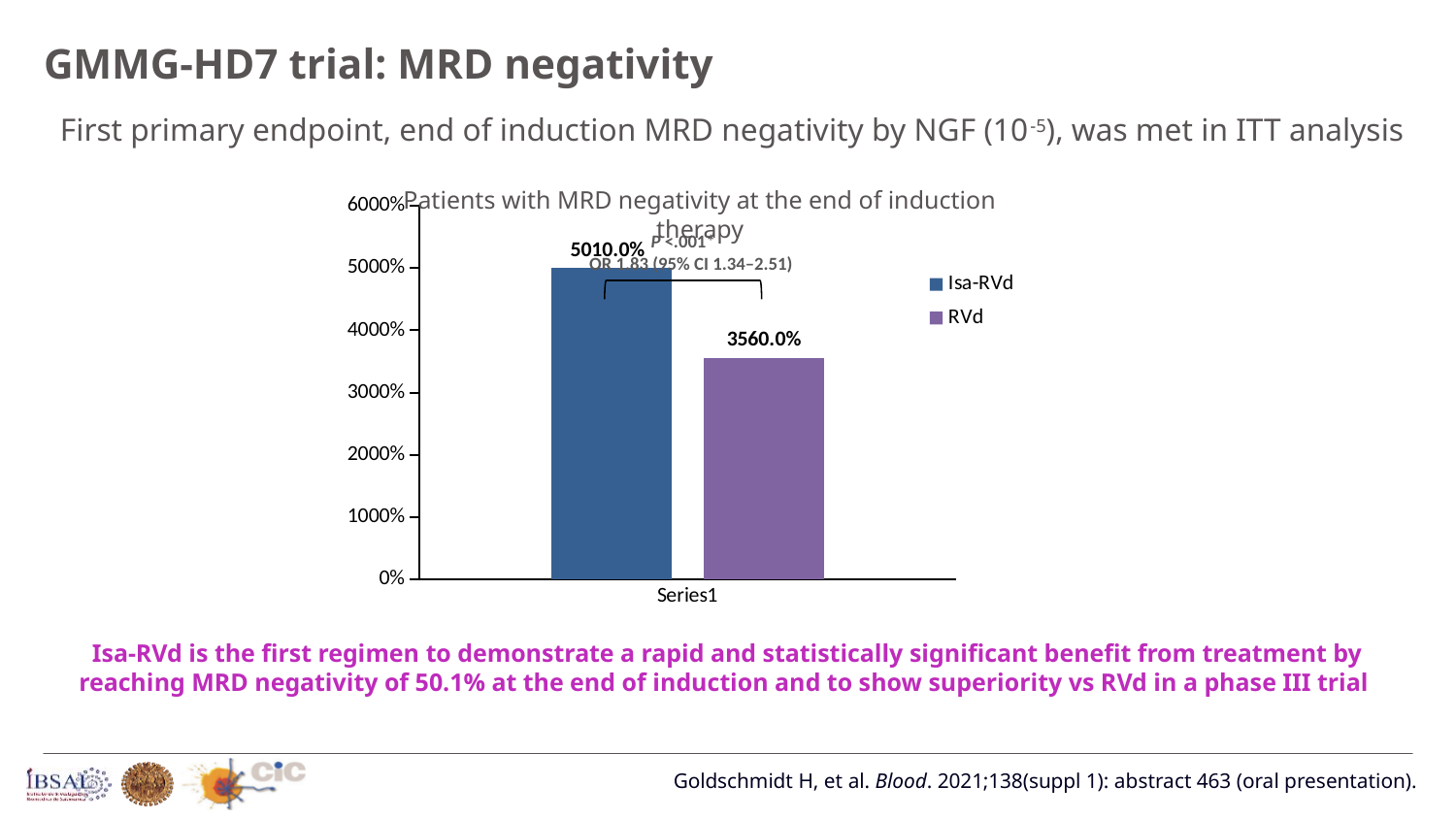
Is the value for Isa-RVd larger or smaller than the value for RVd? larger Is the value for RVd greater or less than 4000%? less Is the value for Isa-RVd greater or less than 4000%? greater Which series has the higher bar in the chart? Isa-RVd What kind of chart is shown on the slide? bar chart Which series has the lower bar in the chart? RVd What value is shown for RVd in the chart? 3560.0% What value is shown for Isa-RVd in the chart? 5010.0% How many series does the chart legend list? 2 How many bars are plotted in the chart? 2 What is the title of the chart? Patients with MRD negativity at the end of induction therapy What is the difference between the Isa-RVd and RVd values shown on the chart? 1450.0%